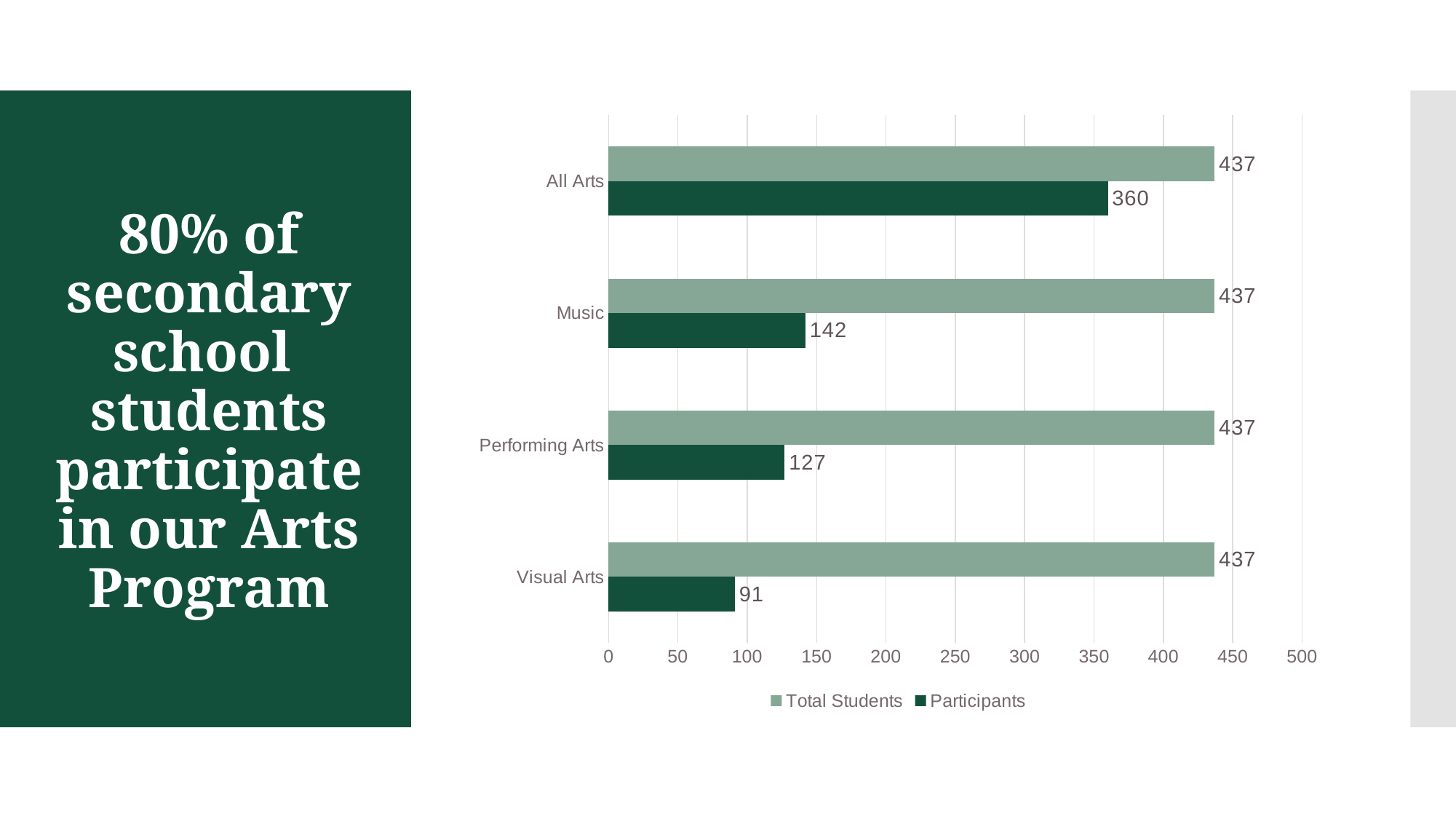
What is the difference between Total Students and Participants for All Arts? 77 Which category has the lowest number of Participants? Visual Arts What is the difference in Participants between Music and Performing Arts? 15 What kind of chart is shown on the slide? Bar chart What is the number of Participants for Music? 142 How many series does the legend list? 2 What is the number of Participants for All Arts? 360 Which category has the highest number of Participants? All Arts Which has more Participants, Music or Visual Arts? Music What is the number of Participants for Visual Arts? 91 How many categories are shown on the chart? 4 What is the Total Students value for Performing Arts? 437